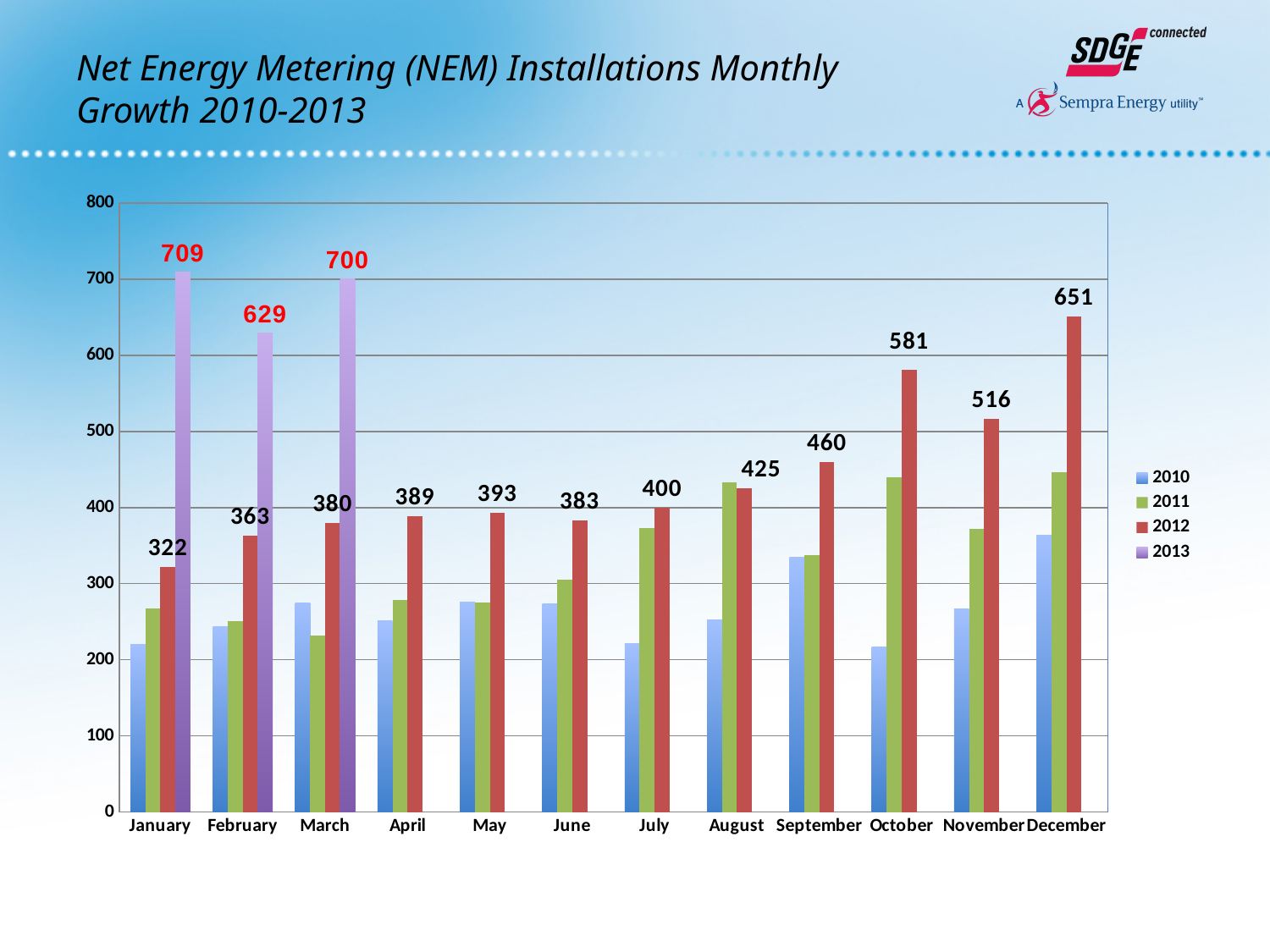
Is the 2010 value for September greater or less than 300? greater Which month has the highest 2012 value? December How many series does the legend list? 4 What is the difference between the 2012 values for December and November? 135 What kind of chart is shown on the slide? Bar chart What is the difference between the 2013 value for January and the 2013 value for February? 80 How many months are shown on the x axis? 12 What is the 2013 value for January? 709 Which month has the lowest 2012 value? January Which is larger, the 2012 value for May or the 2012 value for June? May What is the 2012 value for December? 651 What is the 2012 value for October? 581